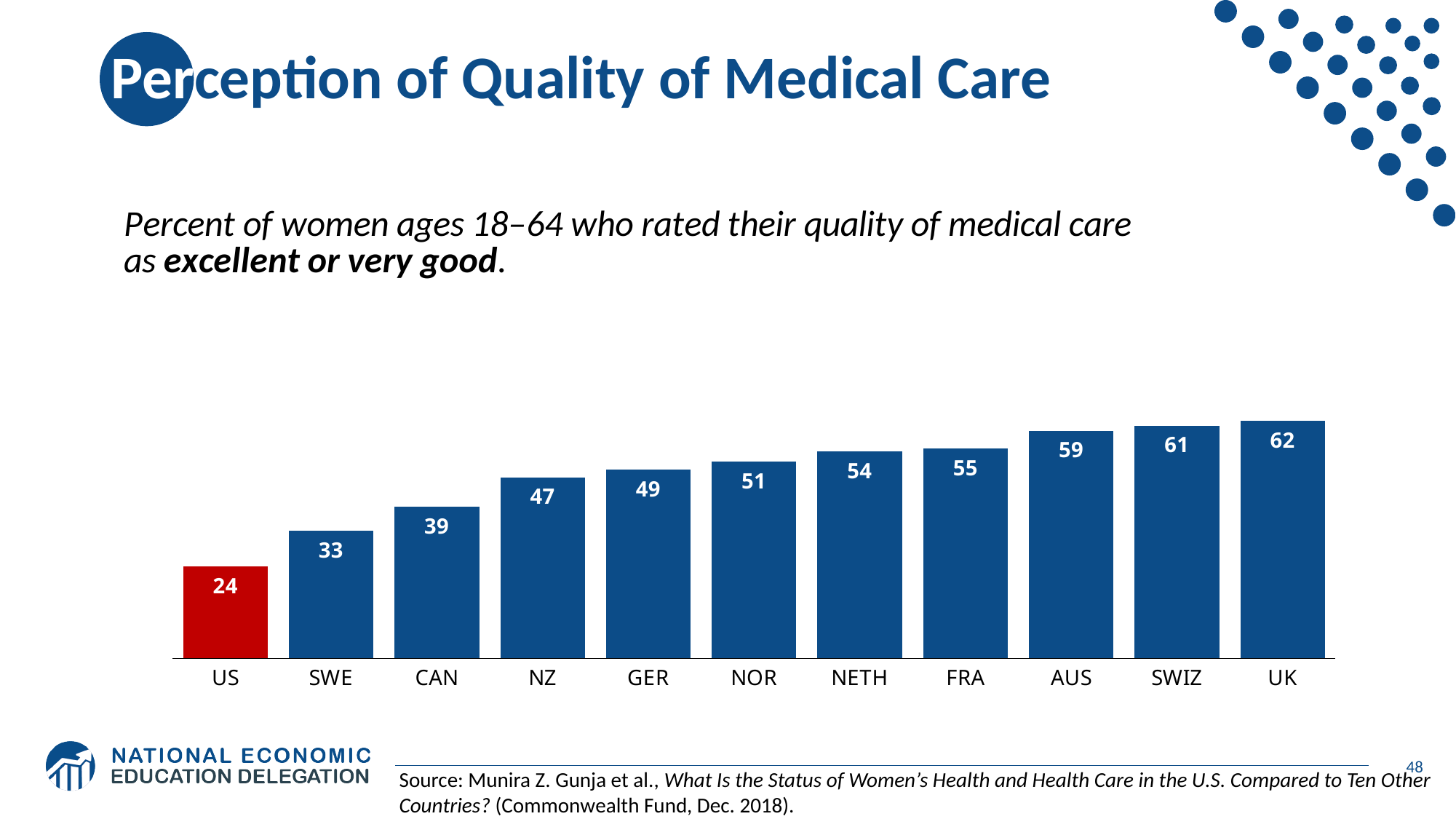
How many countries are shown in the chart? 11 What is the value for the US? 24 Do the values rise or fall from left to right along the x axis? Rise What is the difference between the values for UK and US? 38 Which has a larger value, SWE or NZ? NZ Which country has the highest value? UK What is the value for GER? 49 What kind of chart is shown on the slide? Bar chart Which country has the lowest value? US Which bar is coloured red rather than blue? US What is the value for AUS? 59 What is the difference between the values for NETH and CAN? 15